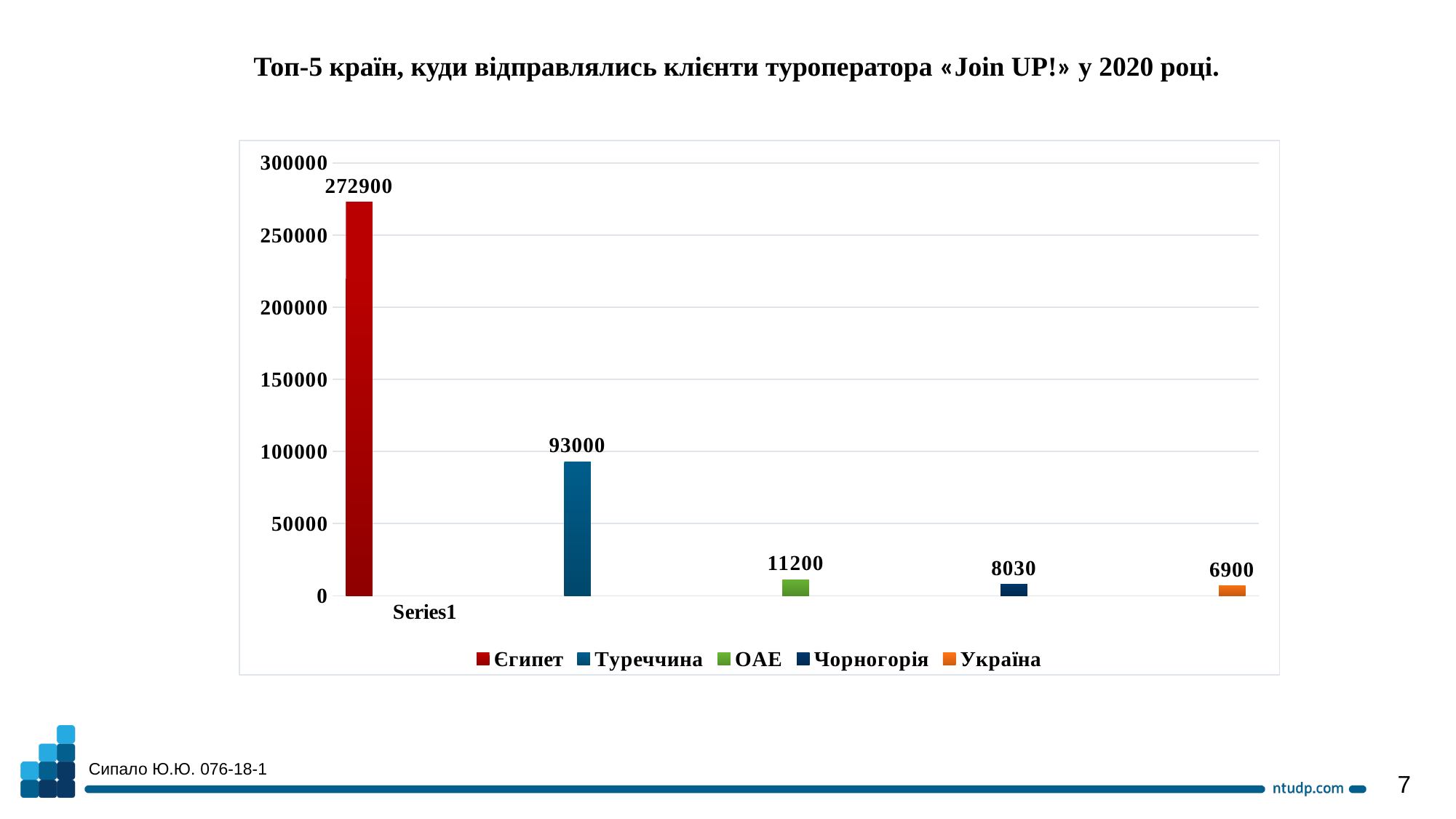
What kind of chart is shown on the slide? bar chart What is the value for Єгипет? 272900 What is the difference between the values for Єгипет and Туреччина? 179900 Which is larger, the value for ОАЕ or the value for Чорногорія? ОАЕ Is the value for Туреччина greater or less than 100000? less What is the value for Україна? 6900 Which country has the highest value? Єгипет What is the value for Туреччина? 93000 What is the value for ОАЕ? 11200 Which country has the lowest value? Україна How many series does the legend list? 5 What is the difference between the values for Чорногорія and Україна? 1130